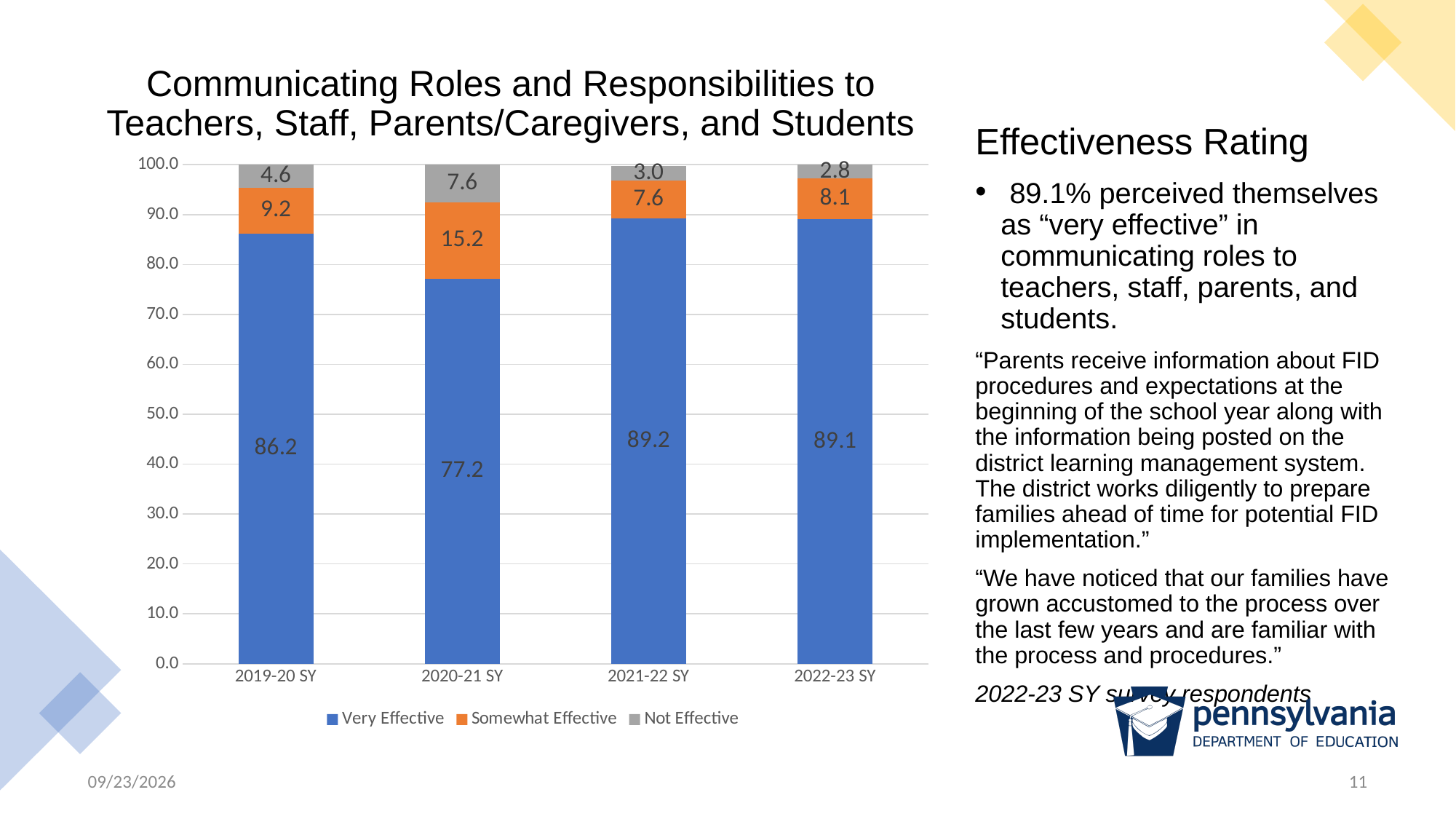
How many series does the legend list? 3 What is the Not Effective value for 2019-20 SY? 4.6 Which school year has the lowest Very Effective value? 2020-21 SY How many school years are shown on the x axis? 4 Is the Very Effective value for 2020-21 SY greater or less than 80? less What kind of chart is shown on the slide? Stacked bar chart What is the Very Effective value for 2020-21 SY? 77.2 Does the Not Effective value rise or fall from 2020-21 SY to 2022-23 SY? Fall What is the difference between the Very Effective values for 2019-20 SY and 2020-21 SY? 9.0 Which school year has the highest Somewhat Effective value? 2020-21 SY What is the Somewhat Effective value for 2022-23 SY? 8.1 Which is larger, the Somewhat Effective value for 2019-20 SY or for 2021-22 SY? 2019-20 SY